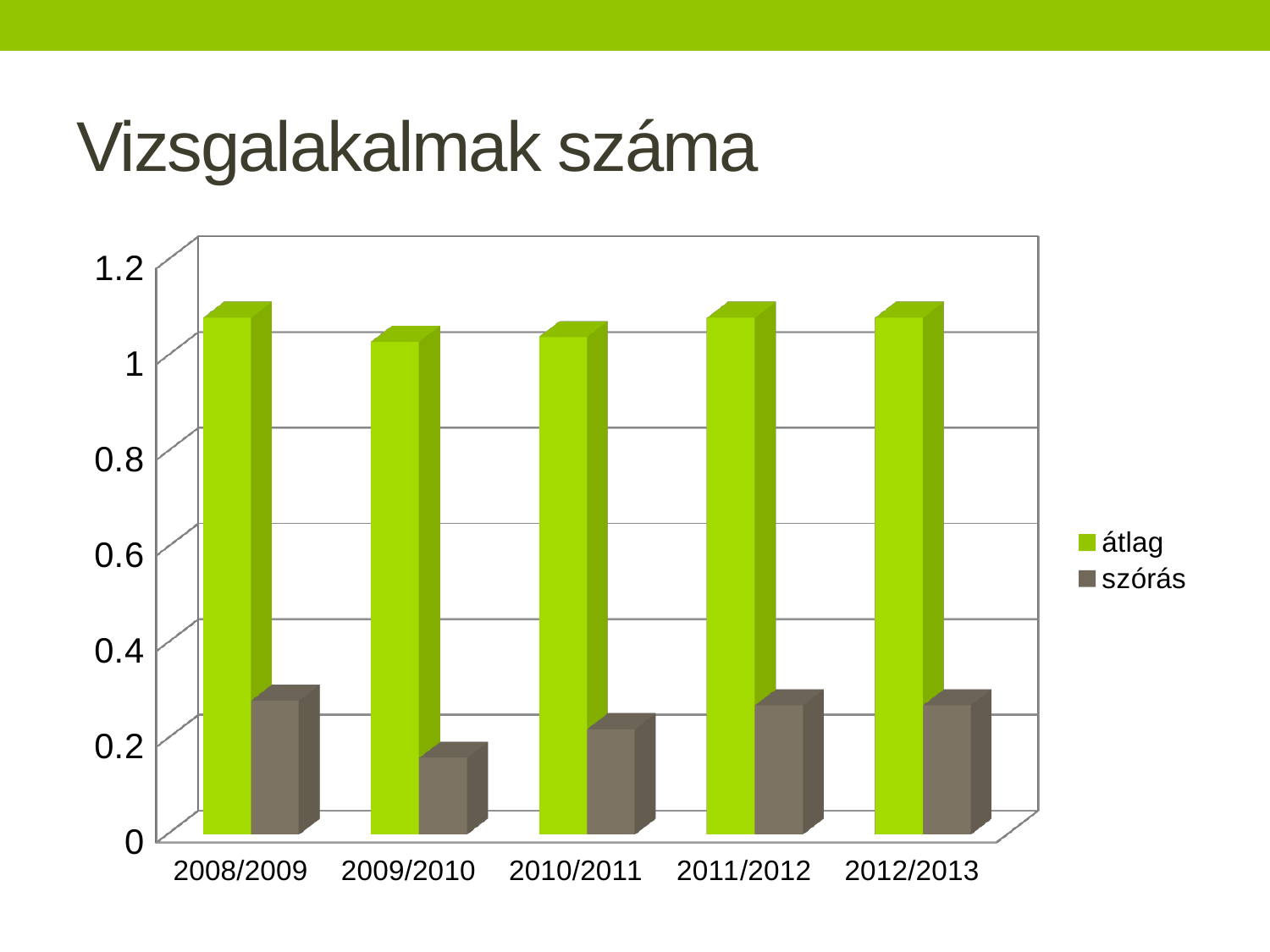
Is the value for átlag in 2012/2013 greater or less than 1.2? less Which series is shown in green? átlag How many categories are shown on the x axis? 5 Which is larger in 2010/2011, átlag or szórás? átlag Which is larger, szórás in 2008/2009 or szórás in 2009/2010? 2008/2009 Is the value for szórás in 2008/2009 greater or less than 0.2? greater What is the title of the slide? Vizsgalakalmak száma Is the value for szórás in 2009/2010 greater or less than 0.2? less Which category has the lowest value for szórás? 2009/2010 What kind of chart is shown on the slide? bar chart How many series does the legend list? 2